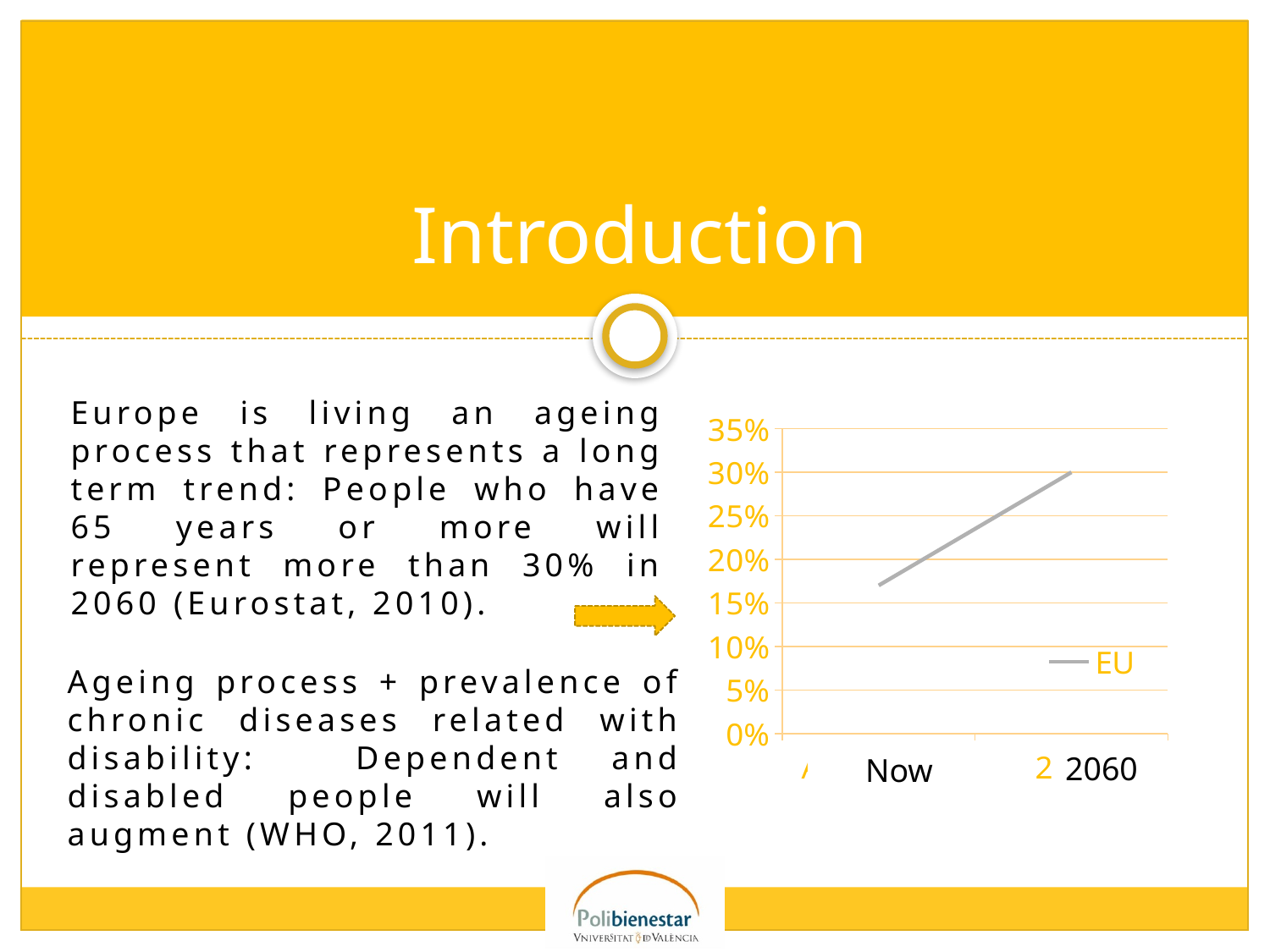
Is the EU value for Now greater or less than 15%? greater What kind of chart is shown on the slide? line chart Which category has the lowest EU value? Now What is the highest value labelled on the chart's vertical axis? 35% Which is larger, the EU value for Now or for 2060? 2060 How many series does the chart's legend list? 1 How many points are plotted on the chart? 2 Is the EU value for Now greater or less than 20%? less Is the EU value for 2060 greater or less than 25%? greater Does the EU value rise or fall from Now to 2060? rise What is the name of the series shown in the chart's legend? EU Which category has the highest EU value? 2060